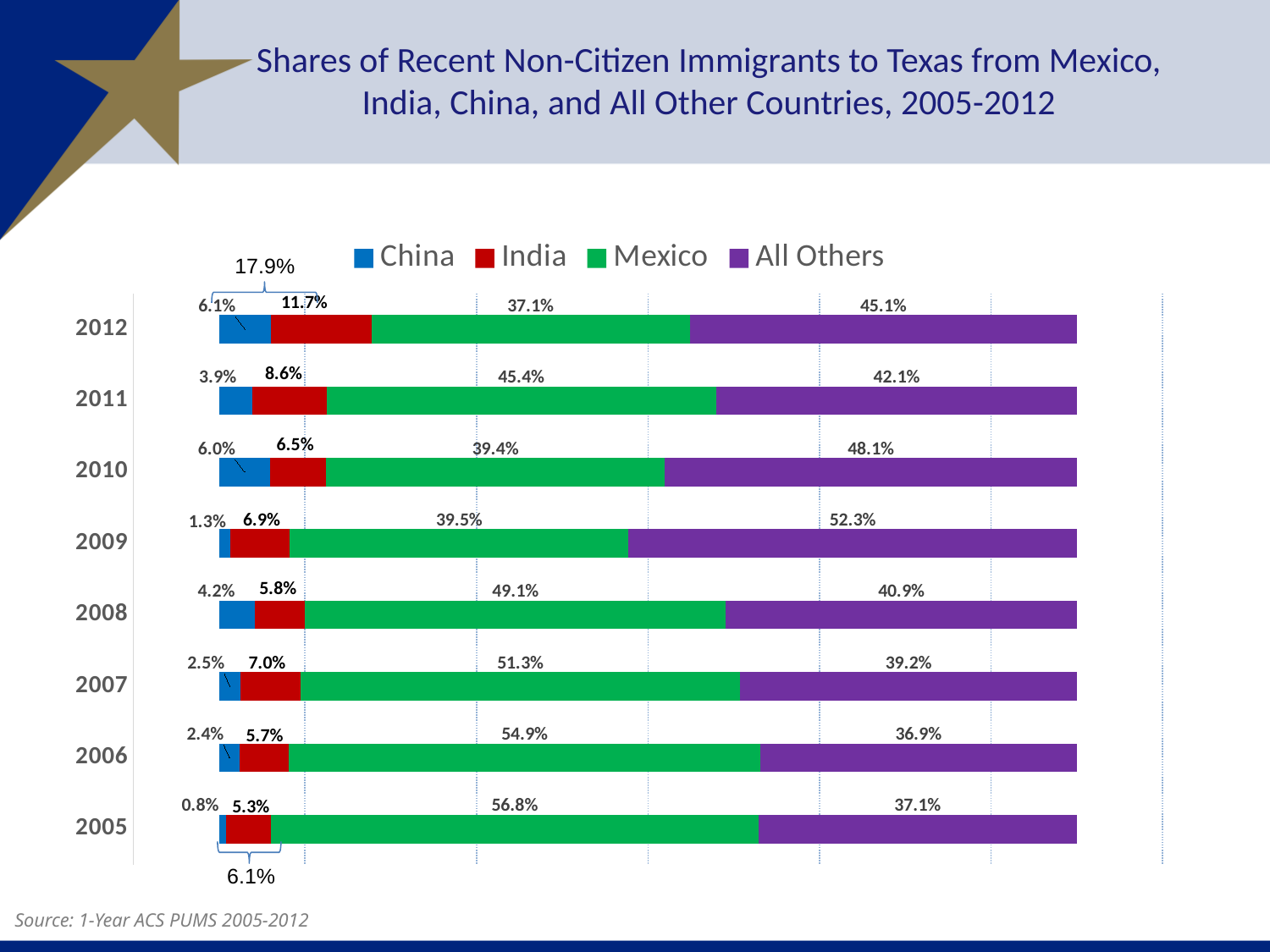
Does the Mexico share generally rise or fall from 2005 to 2012? Fall In which year is the Mexico share the highest? 2005 What kind of chart is shown on the slide? Stacked bar chart In 2008, which is larger: the Mexico share or the All Others share? Mexico What is the share for Mexico in 2012? 37.1% What is the share for China in 2011? 3.9% How many series does the legend list? 4 In which year is the China share the lowest? 2005 What is the share for All Others in 2009? 52.3% What is the combined share of China and India in 2012? 17.9% What is the difference between the Mexico share in 2005 and in 2012? 19.7 percentage points How many years are shown on the chart? 8